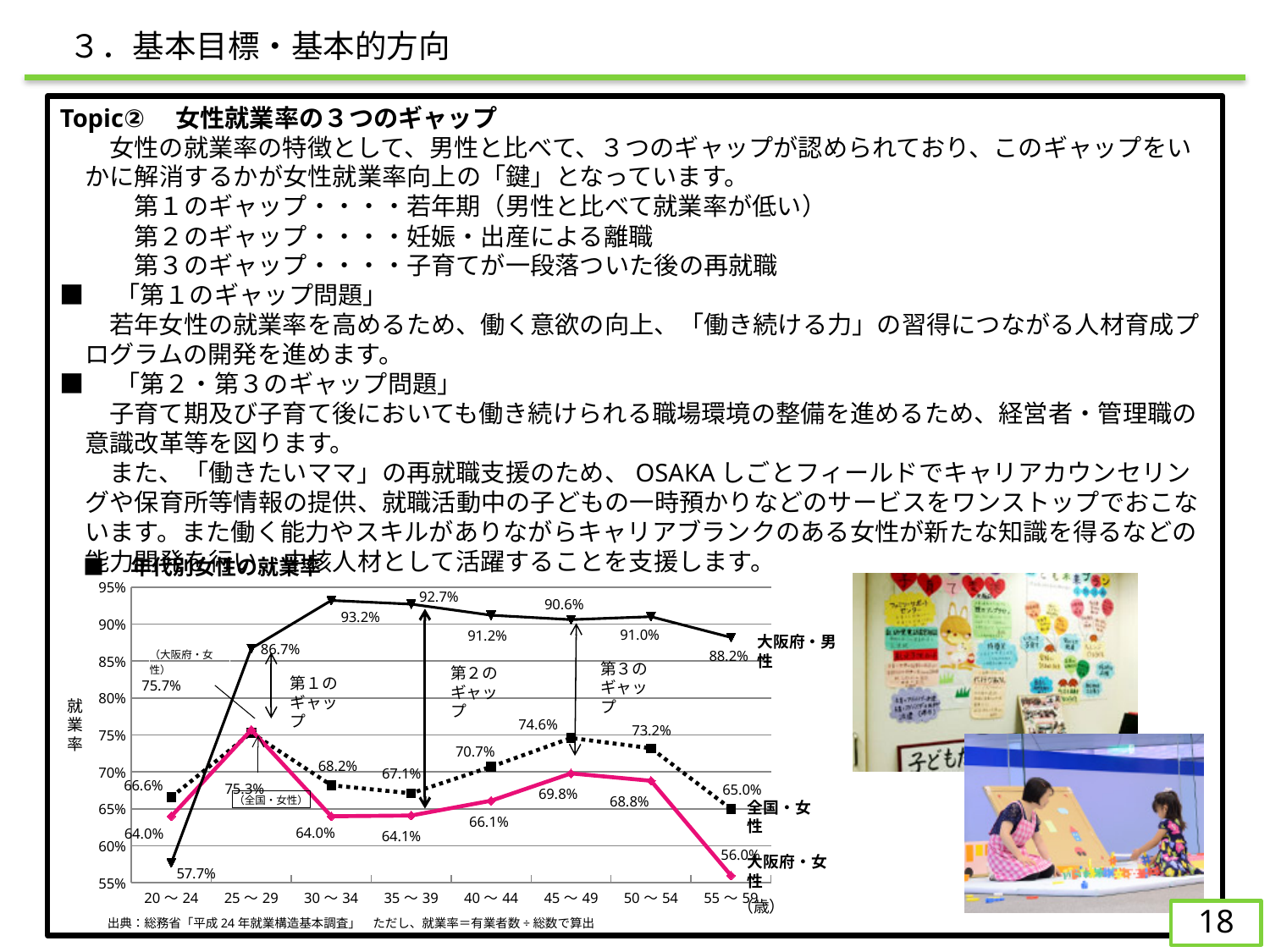
What is the value for 全国・女性 at 45～49? 74.6% Which age group has the lowest value for 大阪府・女性? 55～59 Which age group has the highest value for 大阪府・男? 30～34 What is the difference between 大阪府・男 and 大阪府・女性 at 35～39? 28.6% What is the value for 大阪府・男 at 30～34? 93.2% How many age groups are shown on the x axis of the chart? 8 What is the value for 大阪府・女性 at 55～59? 56.0% What kind of chart is shown on the slide? line chart Which is larger at 25～29: 全国・女性 or 大阪府・女性? 大阪府・女性 Does the value for 大阪府・女性 rise or fall from 50～54 to 55～59? fall What is the value for 大阪府・男 at 20～24? 57.7%